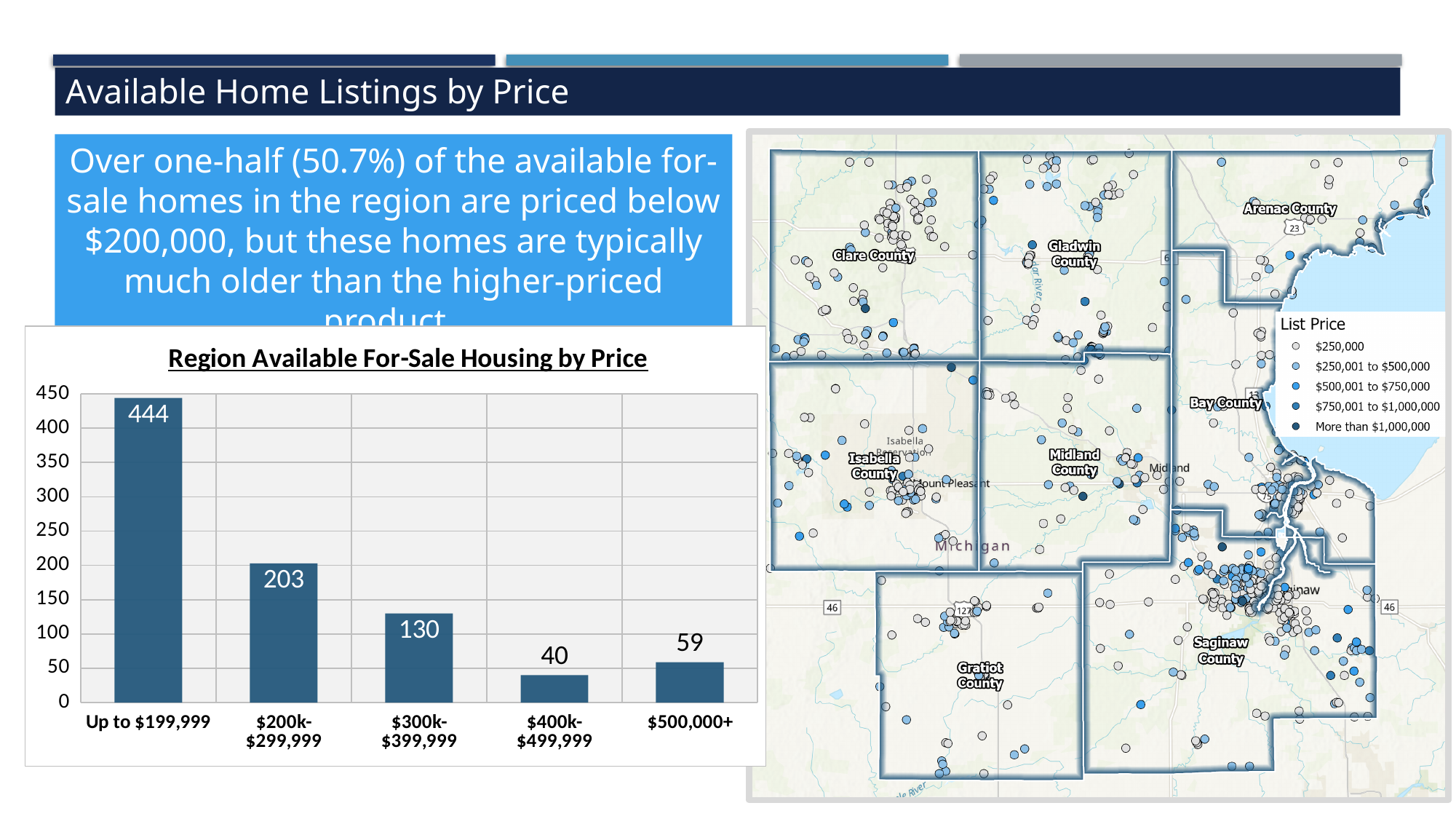
In the 'Region Available For-Sale Housing by Price' chart, is the value for $200k-$299,999 greater or less than 250? less In the 'Region Available For-Sale Housing by Price' chart, do the values generally rise or fall from Up to $199,999 to $400k-$499,999? fall In the 'Region Available For-Sale Housing by Price' chart, which price category has the highest value? Up to $199,999 In the 'Region Available For-Sale Housing by Price' chart, what is the value for $500,000+? 59 In the 'Region Available For-Sale Housing by Price' chart, which price category has the lowest value? $400k-$499,999 In the 'Region Available For-Sale Housing by Price' chart, what is the value for Up to $199,999? 444 What kind of chart is 'Region Available For-Sale Housing by Price'? bar chart In the 'Region Available For-Sale Housing by Price' chart, what is the value for $300k-$399,999? 130 In the 'Region Available For-Sale Housing by Price' chart, what is the difference between the values for Up to $199,999 and $200k-$299,999? 241 In the 'Region Available For-Sale Housing by Price' chart, which is larger: the value for $400k-$499,999 or $500,000+? $500,000+ How many price categories are shown in the 'Region Available For-Sale Housing by Price' chart? 5 What is the title of the bar chart on the slide? Region Available For-Sale Housing by Price